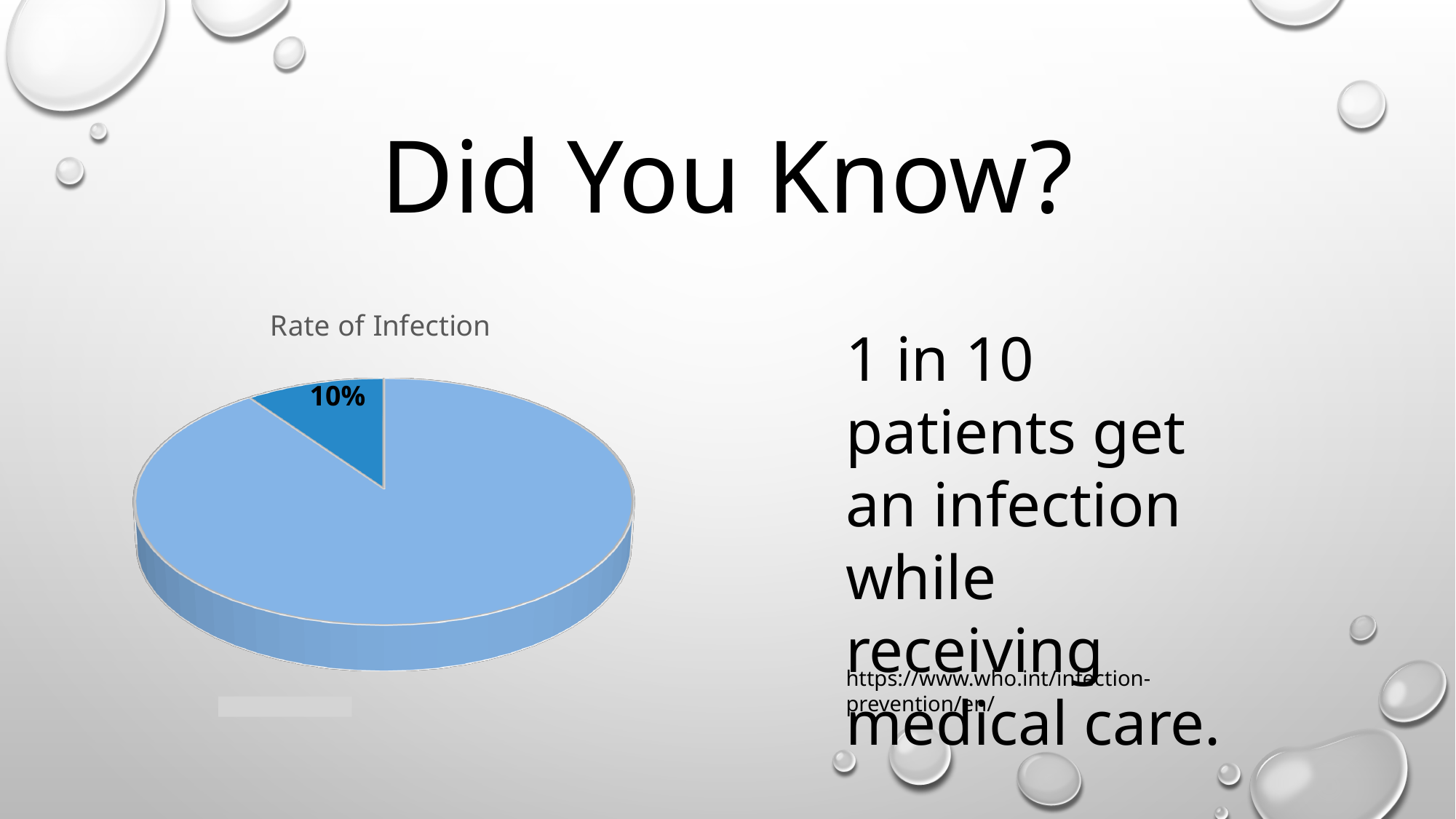
Which slice of the pie chart is the smallest? the dark blue slice (10%) Which slice of the pie chart is larger, the light blue slice or the dark blue slice? the light blue slice What share of the pie does the dark blue slice represent? 10% How many slices does the pie chart have? 2 What colour is the slice labelled 10%? dark blue What kind of chart is shown on the slide? pie chart What percentage is printed on the dark blue slice of the pie chart? 10% What is the title of the chart? Rate of Infection